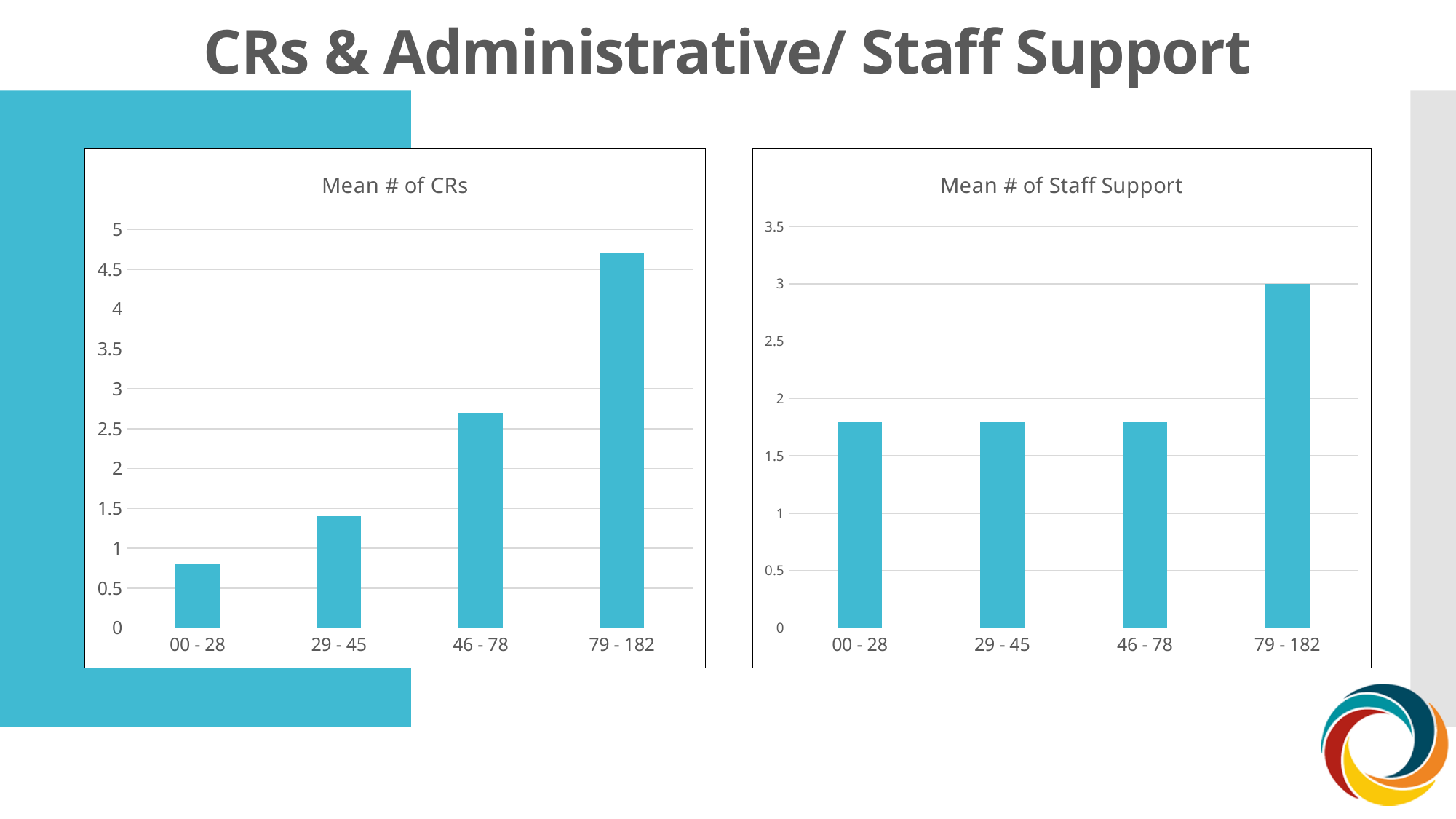
In the "Mean # of CRs" chart, do the values rise or fall from left to right along the x axis? rise In the "Mean # of CRs" chart, which category has the highest value? 79 - 182 In the "Mean # of Staff Support" chart, is the value for 00 - 28 greater or less than 1.5? greater In the "Mean # of CRs" chart, which category has the lowest value? 00 - 28 In the "Mean # of CRs" chart, is the value for 00 - 28 greater or less than 1? less In the "Mean # of CRs" chart, is the value for 46 - 78 greater or less than 2.5? greater What is the title of the chart on the right side of the slide? Mean # of Staff Support What kind of chart is the "Mean # of CRs" chart? bar chart In the "Mean # of Staff Support" chart, which category has the highest value? 79 - 182 In the "Mean # of CRs" chart, which is larger, the value for 29 - 45 or the value for 46 - 78? 46 - 78 How many categories are shown in the "Mean # of Staff Support" chart? 4